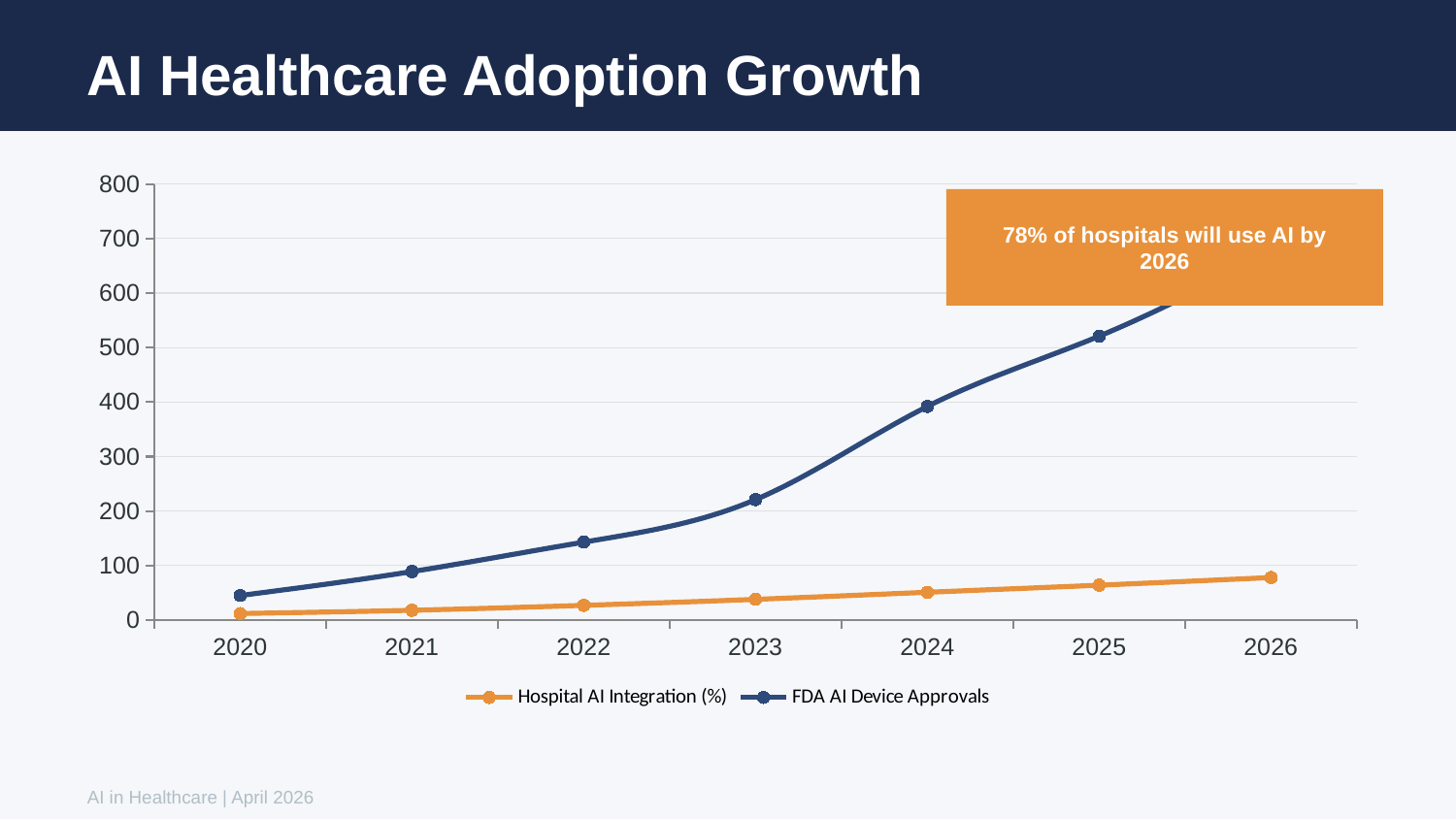
In which year is the Hospital AI Integration (%) value lowest? 2020 How many years are shown on the x axis? 7 How many series does the legend list? 2 Is the Hospital AI Integration (%) value for 2026 greater or less than 100? less Does the Hospital AI Integration (%) series rise or fall from 2020 to 2026? rise What does the orange callout box on the chart say? 78% of hospitals will use AI by 2026 Does the FDA AI Device Approvals series rise or fall from 2020 to 2025? rise Is the FDA AI Device Approvals value for 2022 greater or less than 200? less What kind of chart is shown on the slide? line chart Which series has the larger value in 2025, Hospital AI Integration (%) or FDA AI Device Approvals? FDA AI Device Approvals Is the FDA AI Device Approvals value for 2024 greater or less than 300? greater In which year is the FDA AI Device Approvals value lowest? 2020